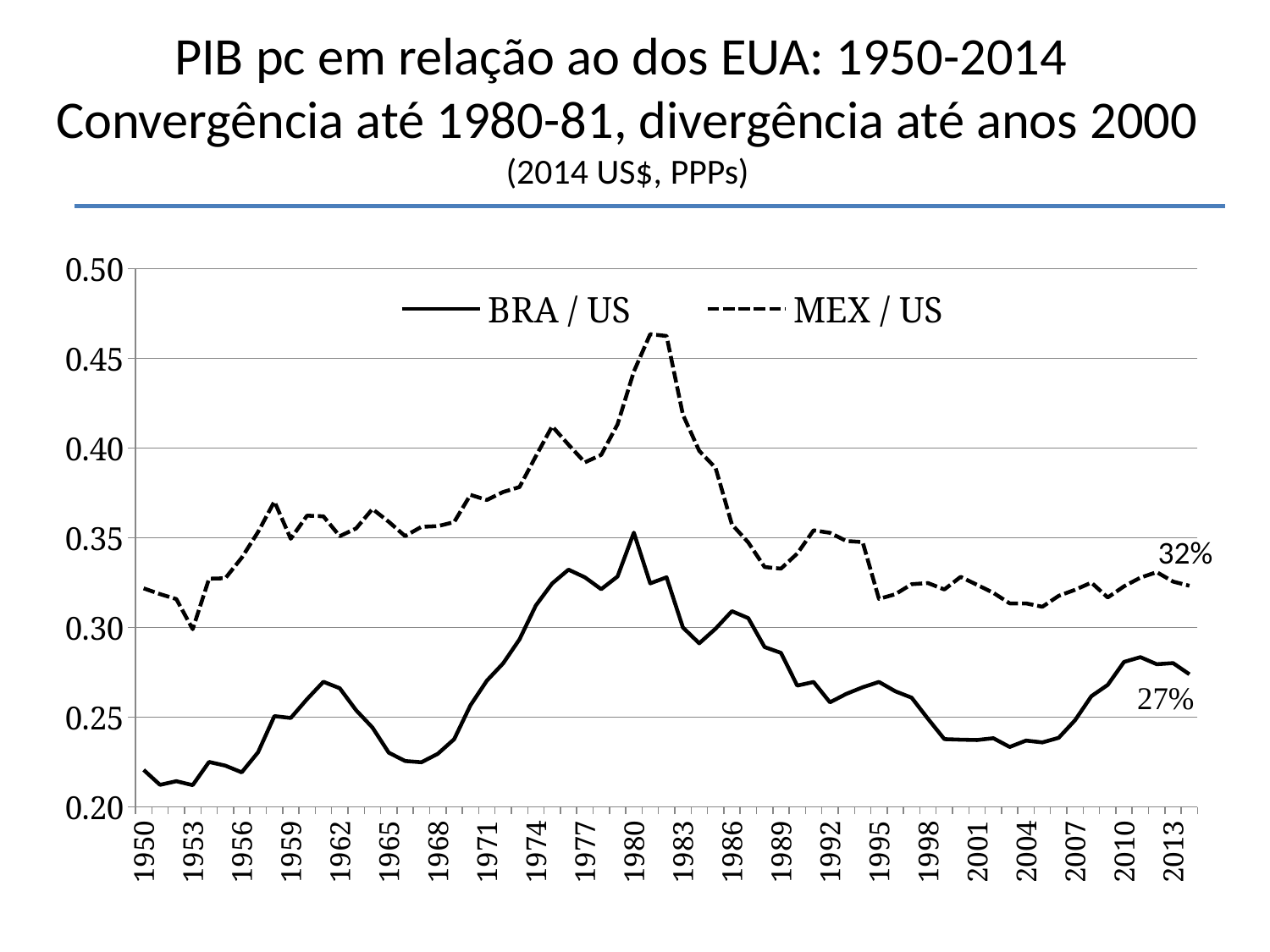
What is the first line of the slide title? PIB pc em relação ao dos EUA: 1950-2014 What kind of chart is shown on the slide? Line chart Is the value for MEX / US in 1953 greater or less than 0.35? less Is the value for MEX / US in 1981 greater or less than 0.45? greater Which series reaches the highest value anywhere on the chart? MEX / US How many series does the legend list? 2 What value is labelled at the end of the MEX / US line? 32% What are the two series named in the legend? BRA / US and MEX / US Is the value for BRA / US in 1950 greater or less than 0.25? less What value is labelled at the end of the BRA / US line? 27% At the end of the period (2014), which series is higher, BRA / US or MEX / US? MEX / US Does the BRA / US line generally rise or fall between 1981 and 2000? fall